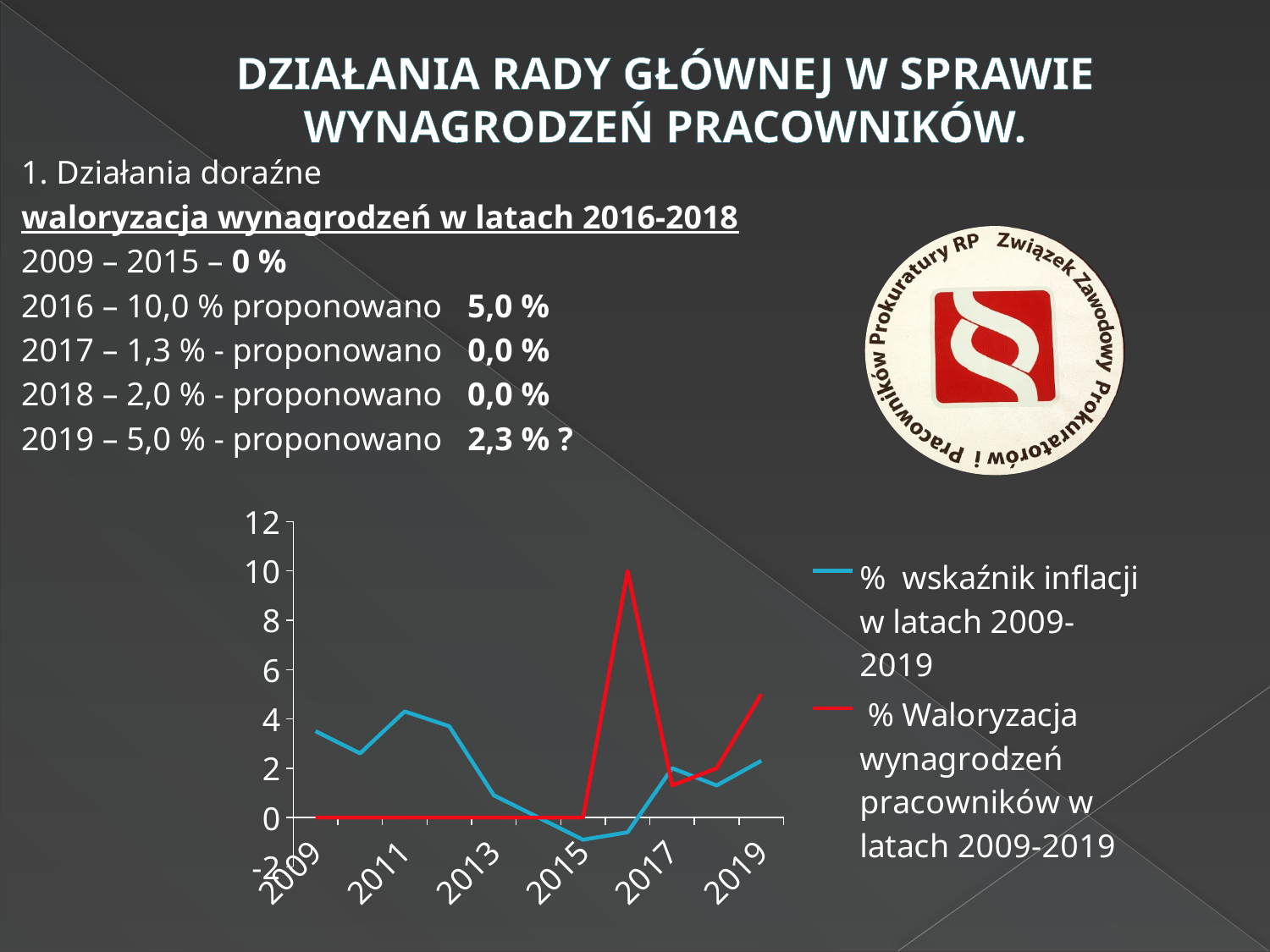
What colour is the line for the '% wskaźnik inflacji' series? blue In 2016, which series has the higher value: '% wskaźnik inflacji' or '% Waloryzacja wynagrodzeń pracowników'? % Waloryzacja wynagrodzeń pracowników What is the value of the '% Waloryzacja wynagrodzeń pracowników' series in 2013? 0 In 2012, which series has the higher value: '% wskaźnik inflacji' or '% Waloryzacja wynagrodzeń pracowników'? % wskaźnik inflacji Is the 2019 value of the '% Waloryzacja wynagrodzeń pracowników' series greater or less than 4? greater What kind of chart is shown on the slide? line chart Is the 2016 value of the '% Waloryzacja wynagrodzeń pracowników' series greater or less than 8? greater How many series does the chart legend list? 2 Does the '% wskaźnik inflacji' series rise or fall between 2012 and 2015? fall Is the 2015 value of the '% wskaźnik inflacji' series greater or less than 0? less Does the '% Waloryzacja wynagrodzeń pracowników' series rise or fall between 2017 and 2019? rise In which year does the '% Waloryzacja wynagrodzeń pracowników' series reach its highest value? 2016